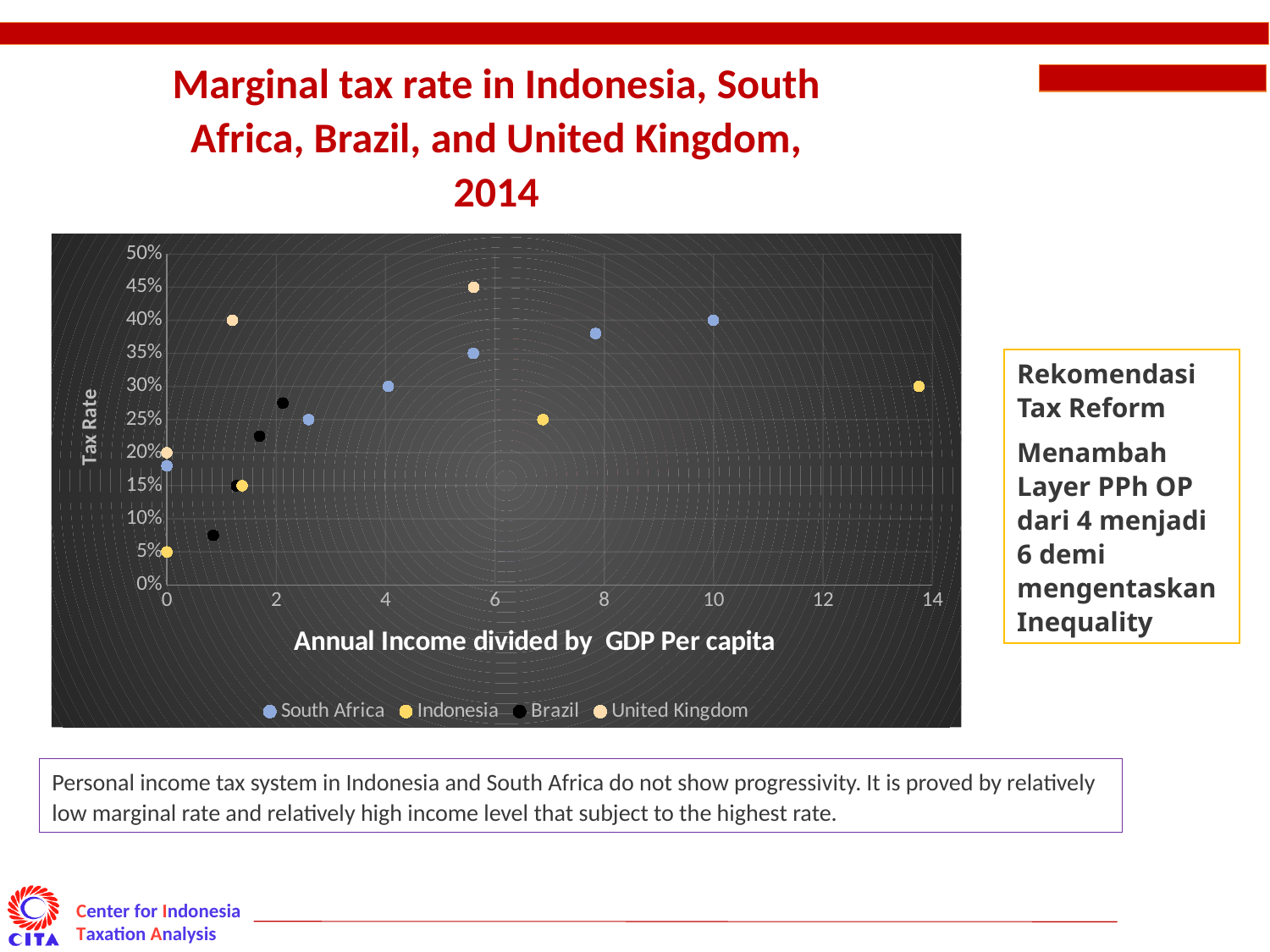
How many data points are plotted for Indonesia? 4 How many data points are plotted for South Africa? 6 How many data points are plotted for United Kingdom? 3 Is the lowest tax rate plotted for Indonesia greater or less than 10%? less Is the highest tax rate plotted for Brazil greater or less than 30%? less Do the South Africa tax rates rise or fall as annual income divided by GDP per capita increases? rise Is the highest tax rate plotted for United Kingdom greater or less than 40%? greater What is the title of the horizontal axis? Annual Income divided by GDP Per capita Which countries are listed in the chart legend? South Africa, Indonesia, Brazil, United Kingdom What kind of chart is shown on the slide? scatter chart How many series does the legend list? 4